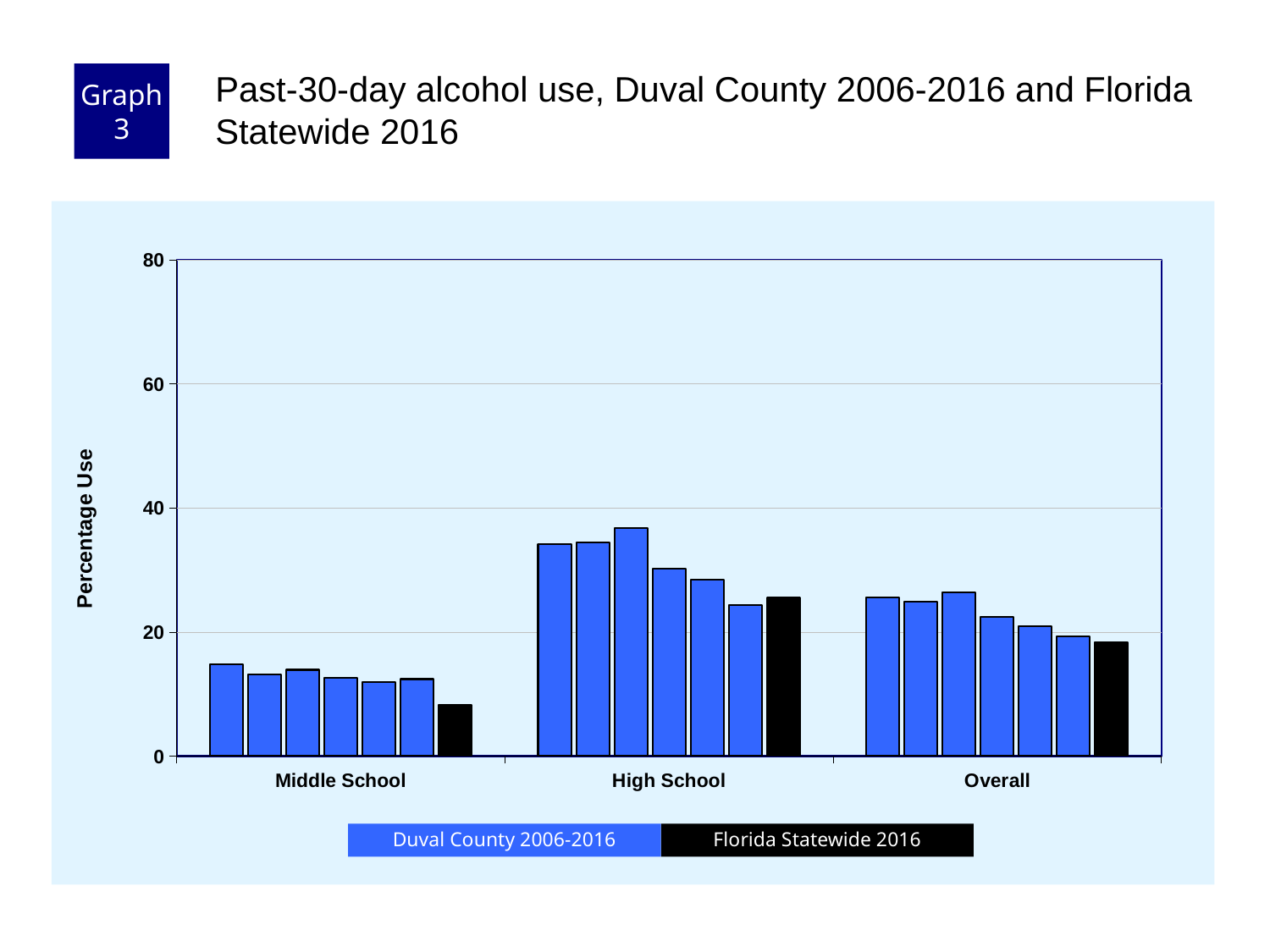
Is the Florida Statewide 2016 value for High School greater or less than 20? greater Which is larger, the Florida Statewide 2016 value for High School or for Middle School? High School How many categories are shown on the x axis? 3 Is the tallest Duval County 2006-2016 bar for High School greater or less than 40? less Which category has the lowest bars overall? Middle School Is the Florida Statewide 2016 value for Overall greater or less than 20? less Which colour represents Florida Statewide 2016 in the legend? black Which category has the highest bars overall? High School What kind of chart is shown on the slide? bar chart What is the label on the y axis? Percentage Use How many series does the legend list? 2